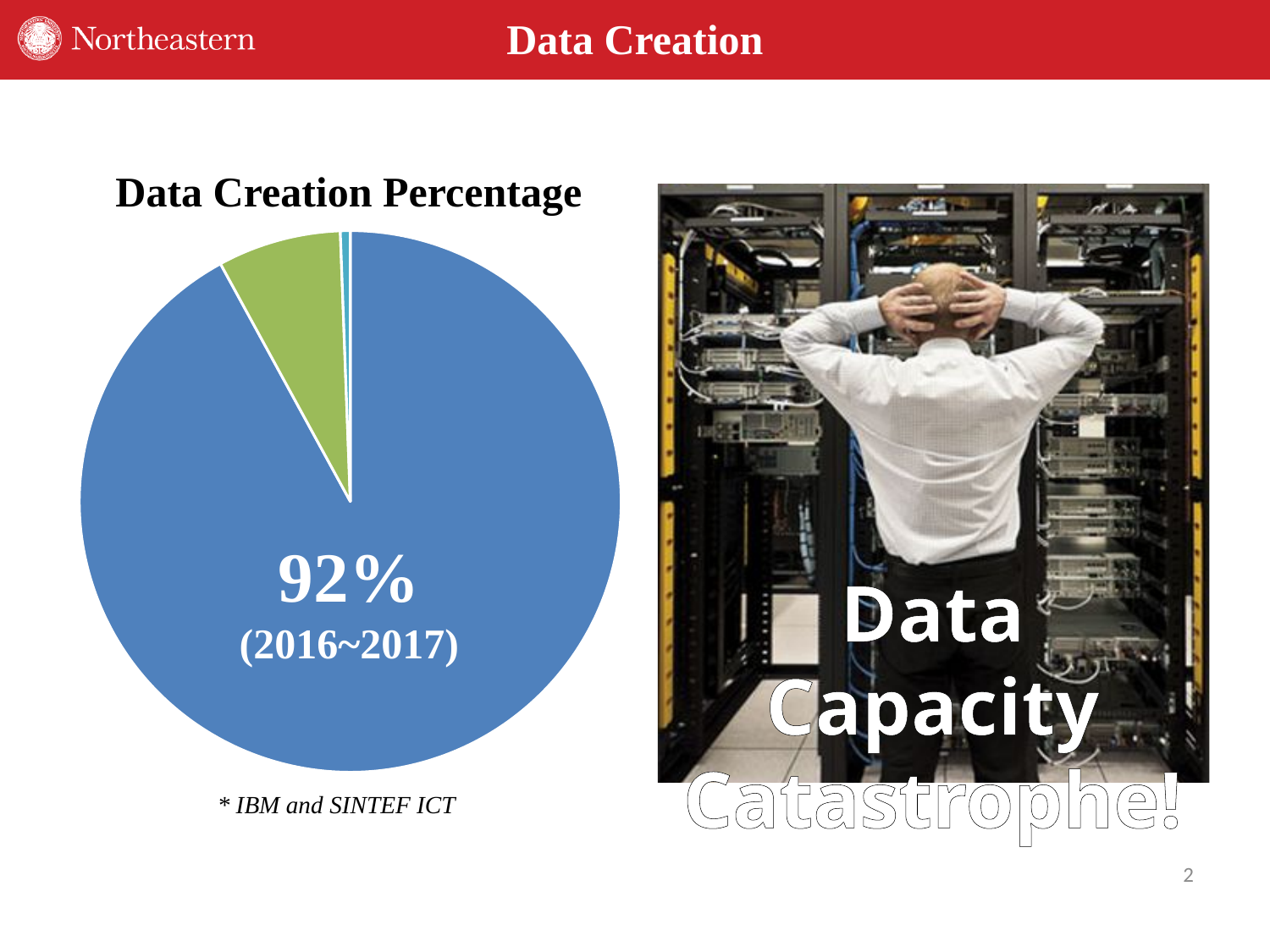
How many slices does the pie chart have? 3 Which colour slice is the largest in the pie chart? blue What is the title of the chart on the slide? Data Creation Percentage What source is cited below the pie chart? IBM and SINTEF ICT Which colour slice is the smallest in the pie chart? teal Which is larger in the pie chart, the green slice or the teal slice? green What share of the pie does the slice labelled 2016~2017 represent? 92% What kind of chart is shown on the slide? pie chart Which period is labelled on the largest slice of the pie chart? 2016~2017 What percentage is printed on the largest slice of the pie chart? 92%